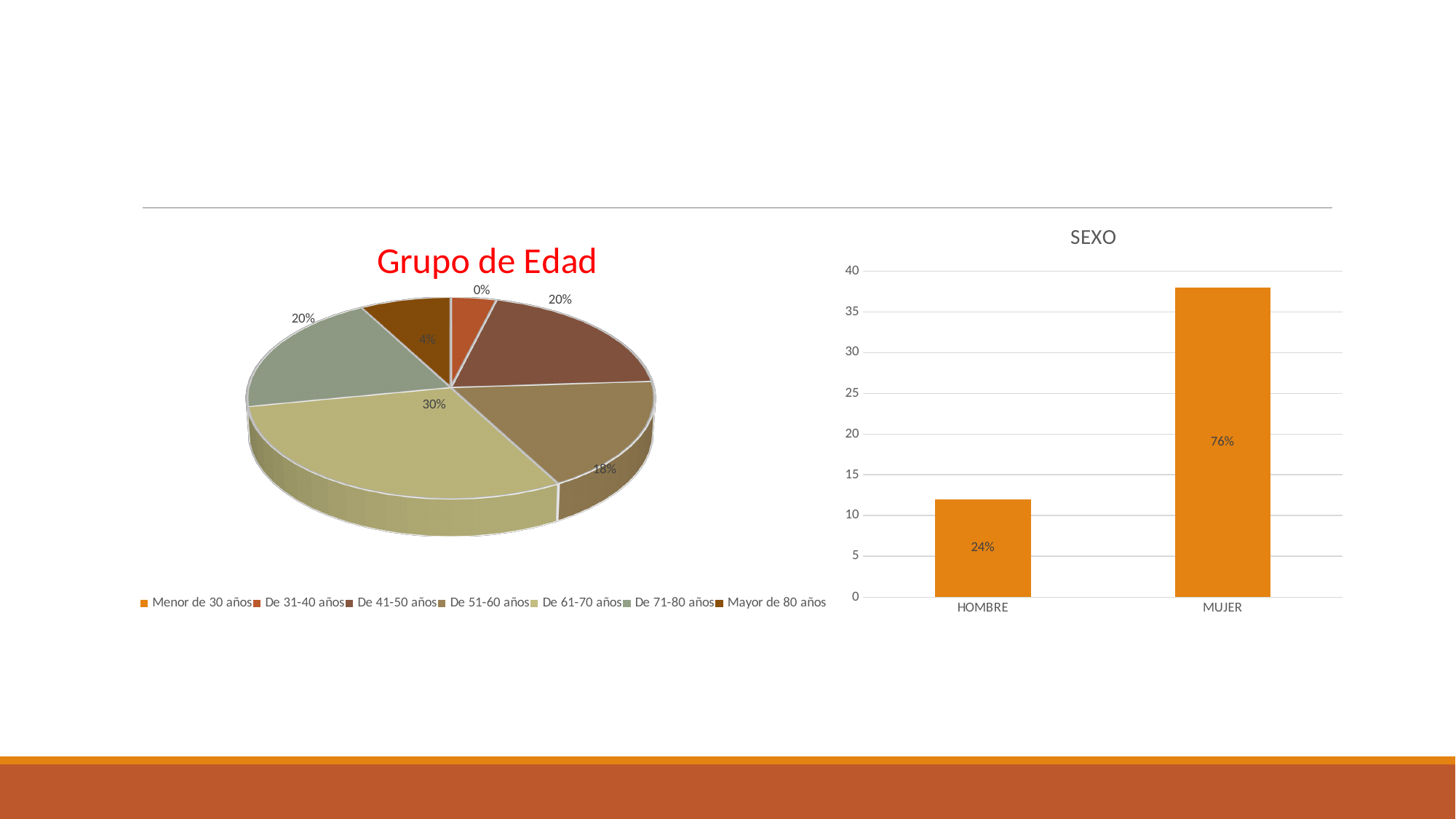
In the 'SEXO' bar chart, is the value for MUJER greater or less than 35? greater How many categories does the legend of the 'Grupo de Edad' pie chart list? 7 In the 'Grupo de Edad' pie chart, which age group has the largest slice? De 61-70 años In the 'Grupo de Edad' pie chart, what share is shown for 'De 61-70 años'? 30% In the 'SEXO' bar chart, which category has the taller bar? MUJER In the 'SEXO' bar chart, is the value for HOMBRE greater or less than 15? less In the 'Grupo de Edad' pie chart, what share is shown for 'De 51-60 años'? 18% What type of chart is the 'SEXO' chart? bar chart In the 'SEXO' bar chart, what data label is shown on the HOMBRE bar? 24% In the 'SEXO' bar chart, what data label is shown on the MUJER bar? 76% In the 'Grupo de Edad' pie chart, what share is shown for 'De 71-80 años'? 20% What type of chart is the 'Grupo de Edad' chart? pie chart